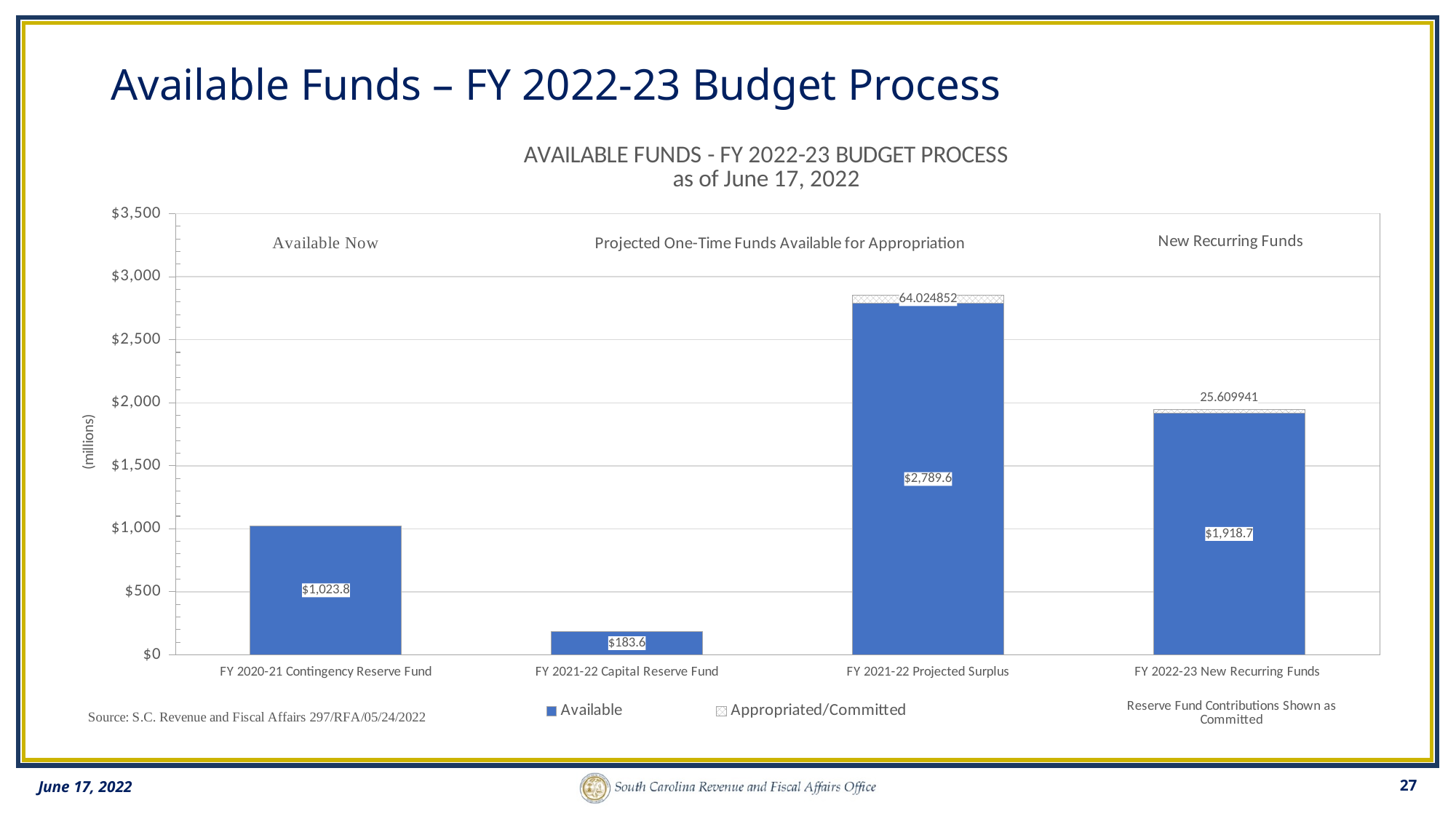
How many categories are shown on the x axis? 4 What is the Available value for FY 2021-22 Capital Reserve Fund? $183.6 What is the Appropriated/Committed value for FY 2021-22 Projected Surplus? 64.024852 Which category has the highest Available value? FY 2021-22 Projected Surplus Which is larger, the Available value for FY 2020-21 Contingency Reserve Fund or for FY 2022-23 New Recurring Funds? FY 2022-23 New Recurring Funds What is the Available value for FY 2021-22 Projected Surplus? $2,789.6 Which category has the lowest Available value? FY 2021-22 Capital Reserve Fund What is the Appropriated/Committed value for FY 2022-23 New Recurring Funds? 25.609941 What is the difference between the Available values for FY 2021-22 Projected Surplus and FY 2022-23 New Recurring Funds? $870.9 What is the Available value for FY 2020-21 Contingency Reserve Fund? $1,023.8 Is the Available value for FY 2021-22 Capital Reserve Fund greater or less than $500? less How many series does the legend list? 2